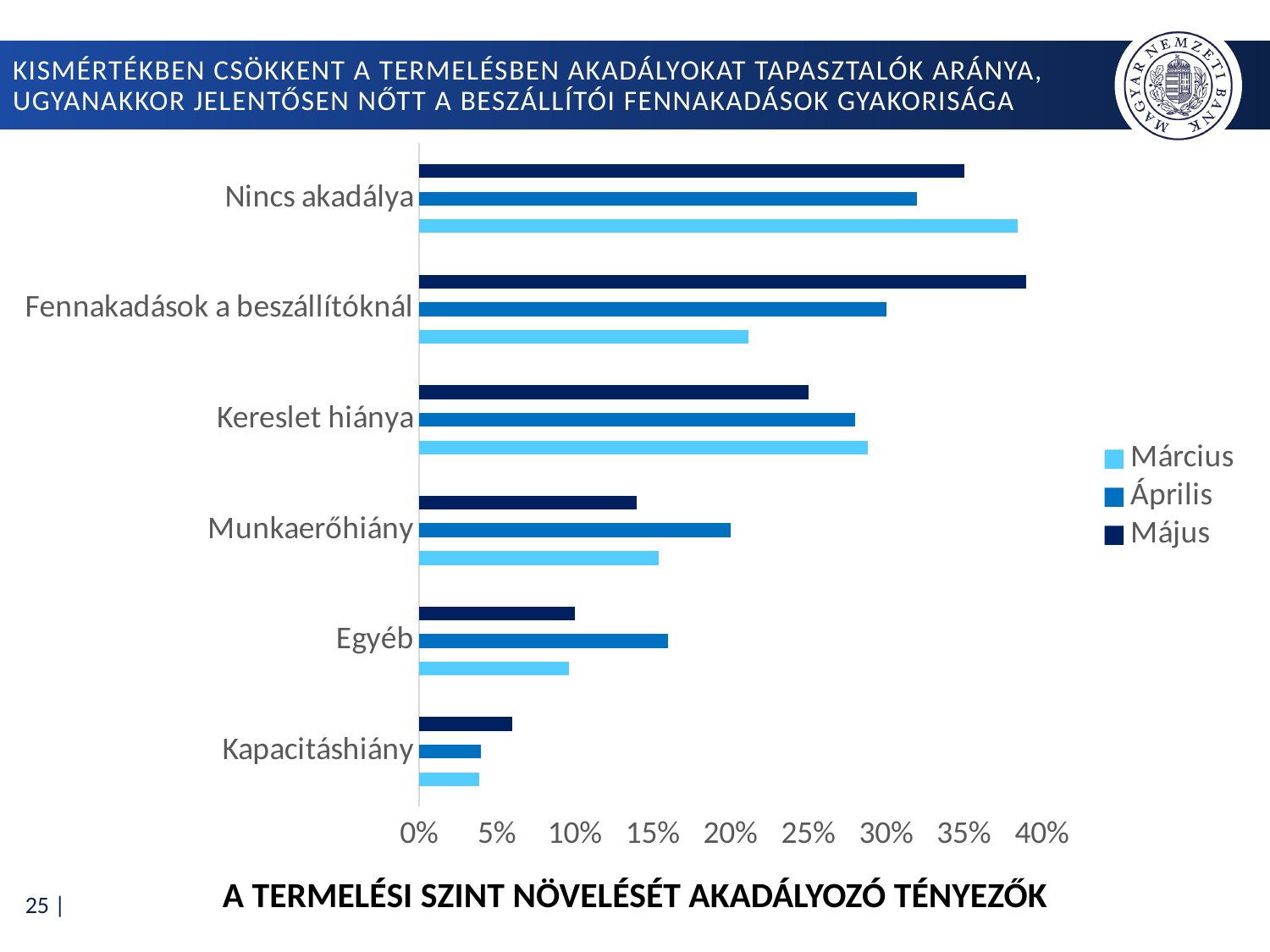
What is the title of the chart? A TERMELÉSI SZINT NÖVELÉSÉT AKADÁLYOZÓ TÉNYEZŐK Is the Május value for Kapacitáshiány greater or less than 10%? less For Fennakadások a beszállítóknál, which is larger: the Május value or the Március value? Május Which category has the highest value for the Március series? Nincs akadálya What kind of chart is shown on the slide? bar chart Is the Március value for Fennakadások a beszállítóknál greater or less than 25%? less Is the Április value for Munkaerőhiány greater or less than 15%? greater How many categories are shown on the chart? 6 How many series does the legend list? 3 Which category has the highest value for the Május series? Fennakadások a beszállítóknál Which category has the lowest value for the Május series? Kapacitáshiány